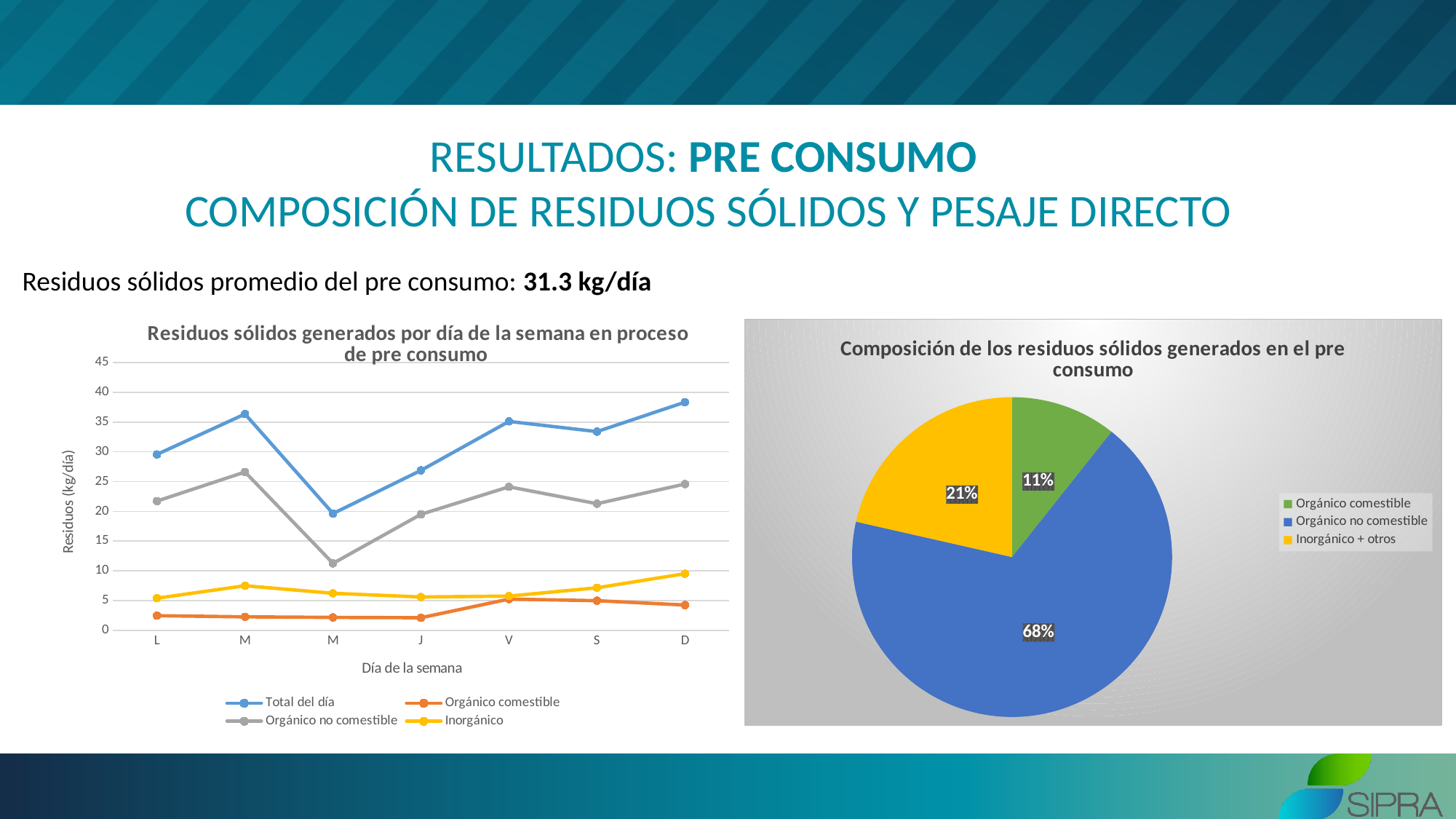
What kind of chart is the chart titled 'Residuos sólidos generados por día de la semana en proceso de pre consumo'? line chart In the line chart on the left, on which day is 'Total del día' highest? D What kind of chart is the chart titled 'Composición de los residuos sólidos generados en el pre consumo'? pie chart In the line chart on the left, how many series does the legend list? 4 In the line chart on the left, is the value of 'Total del día' for D greater or less than 35? greater In the pie chart on the right, what is the difference in percentage points between 'Orgánico no comestible' and 'Inorgánico + otros'? 47 percentage points In the line chart on the left, which series is higher on day D: 'Inorgánico' or 'Orgánico comestible'? Inorgánico In the pie chart on the right, which category has the smallest slice? Orgánico comestible In the line chart on the left, is the value of 'Orgánico no comestible' at the second M greater or less than 15? less In the line chart on the left, on which day is 'Total del día' lowest? M (the second M, third point) In the line chart on the left, how many days are plotted along the x axis? 7 In the pie chart on the right, what share does 'Orgánico no comestible' have? 68%